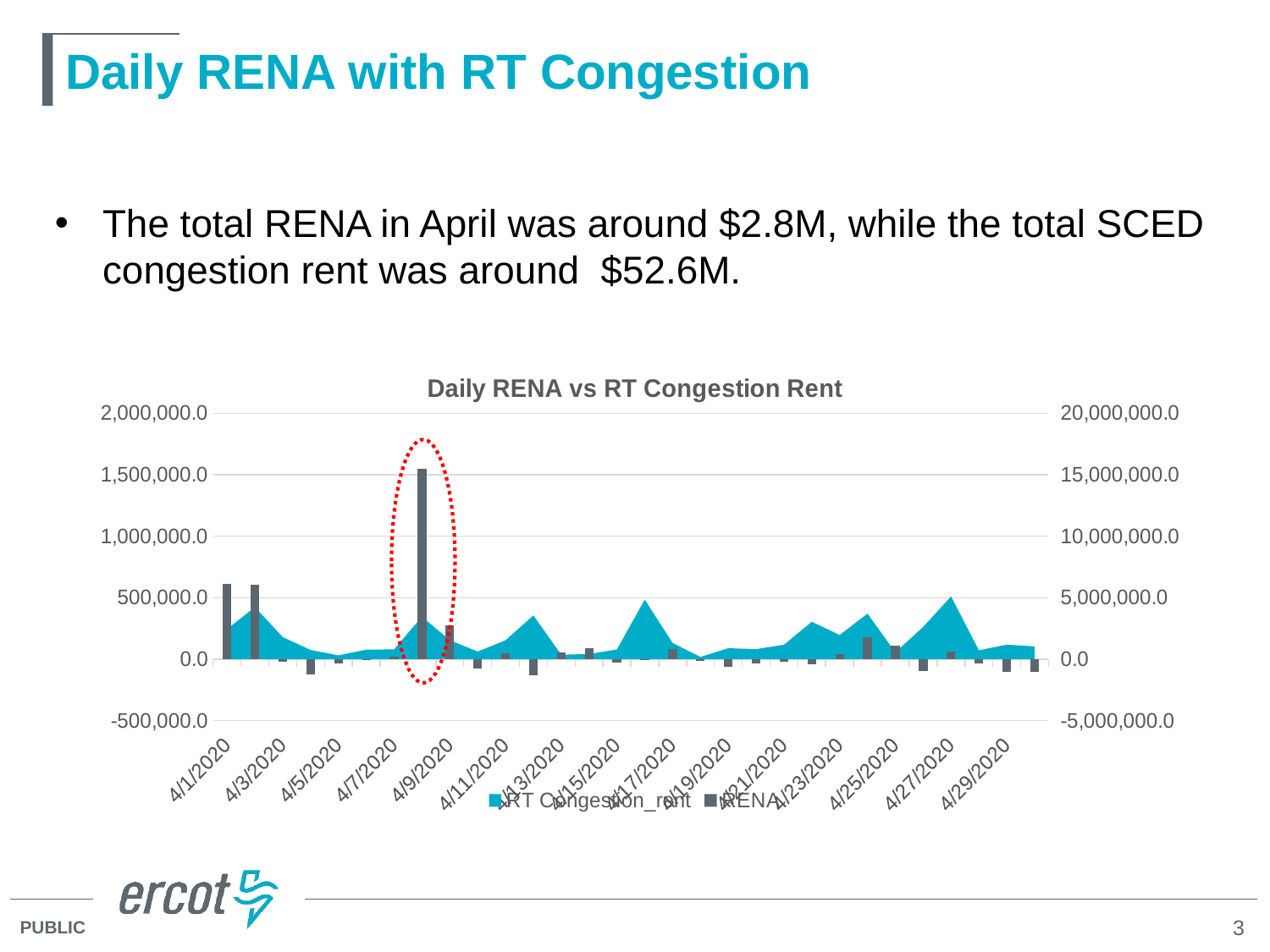
What is the highest value shown on the right-hand vertical axis? 20,000,000.0 How many date labels are shown along the x axis of the chart? 15 What is the lowest value shown on the left-hand vertical axis? -500,000.0 What is the highest value shown on the left-hand vertical axis? 2,000,000.0 What is the title of the chart on the slide? Daily RENA vs RT Congestion Rent On which date does the tallest RENA bar occur? 4/8/2020 What are the two series named in the chart legend? RT Congestion_rent and RENA Which has the larger RENA bar, 4/9/2020 or 4/1/2020? 4/1/2020 Is the RENA bar on 4/1/2020 greater or less than 500,000.0 on the left-hand axis? greater How many series does the chart legend list? 2 What kind of chart is shown on the slide? Combined bar and area chart